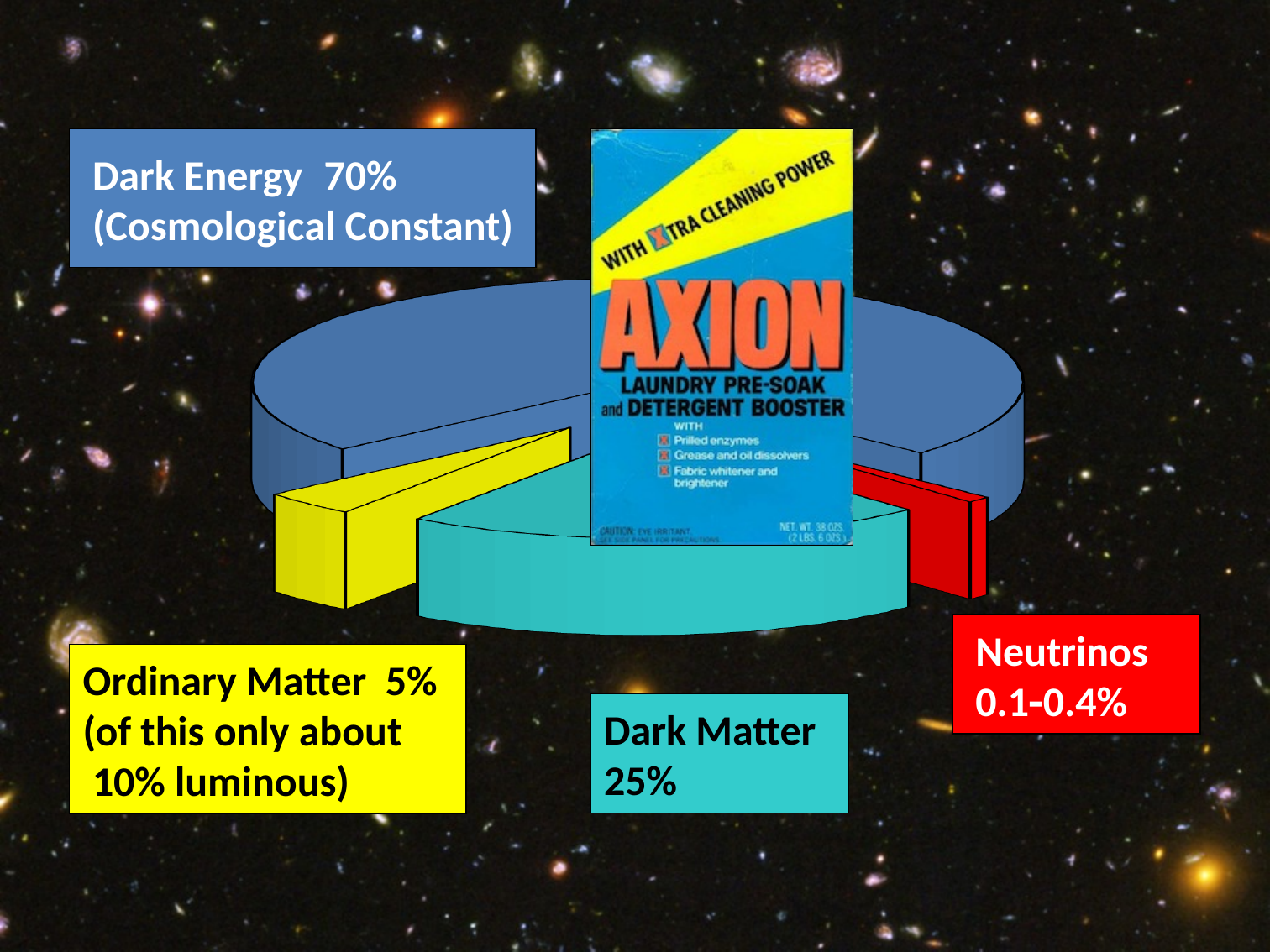
What share of the pie is labelled for Dark Matter? 25% What share of the pie is labelled for Dark Energy? 70% How many slices does the pie chart have? 4 What colour is the Neutrinos slice? red Which slice of the pie is the smallest? Neutrinos What kind of chart is shown on the slide? pie chart What is the difference between the Dark Energy share and the Dark Matter share? 45% What share of the pie is labelled for Ordinary Matter? 5% Which slice of the pie is the largest? Dark Energy Which is larger, the Dark Matter slice or the Ordinary Matter slice? Dark Matter What colour is the Dark Matter slice? cyan What share is labelled for Neutrinos? 0.1-0.4%